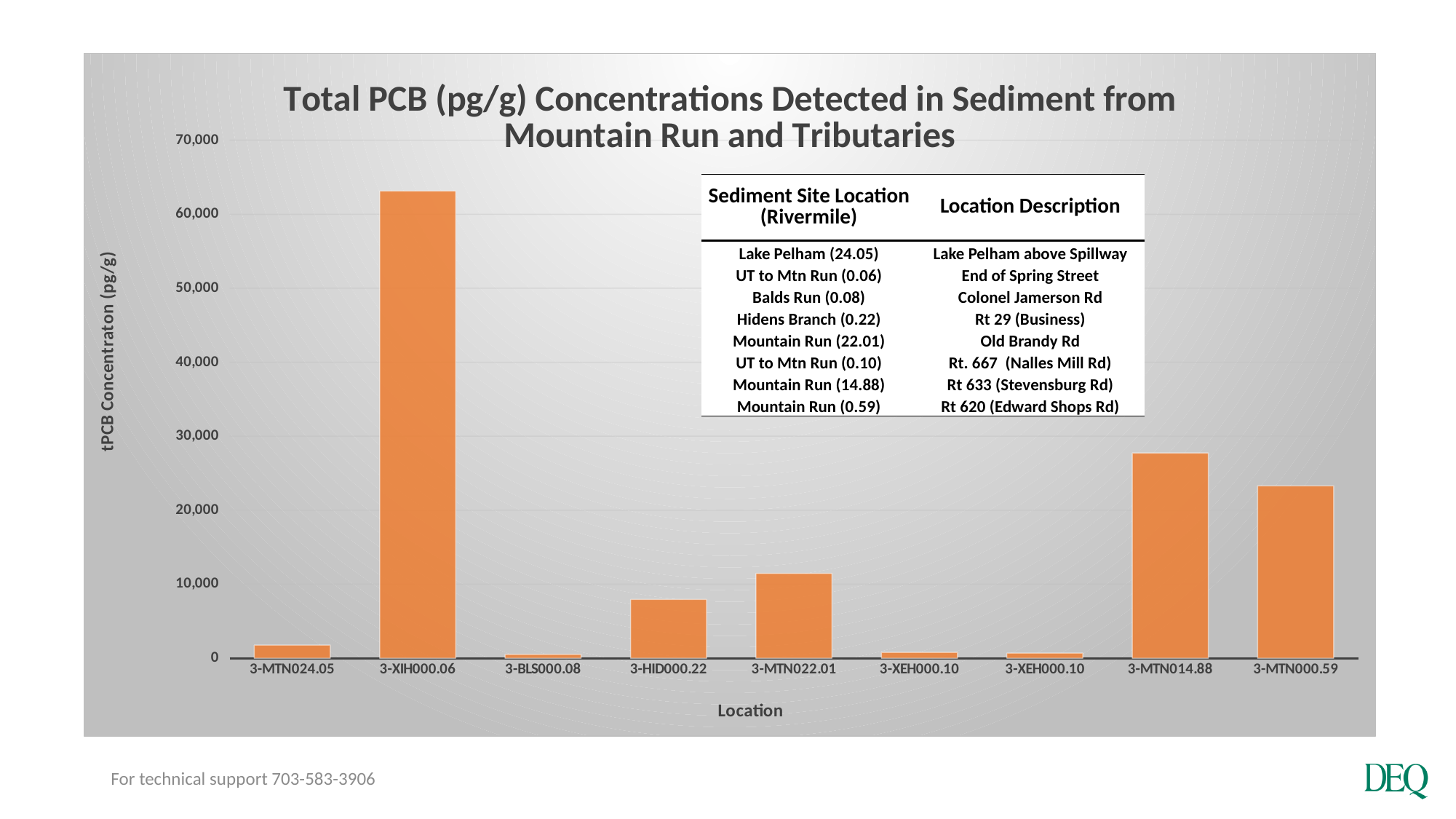
Is the value for 3-MTN014.88 greater or less than 30,000? less Is the value for 3-XIH000.06 greater or less than 60,000? greater Which has the larger tPCB concentration, 3-MTN022.01 or 3-HID000.22? 3-MTN022.01 What kind of chart is shown on the slide? bar chart How many locations (bars) are plotted on the chart? 9 What is the label of the vertical axis? tPCB Concentraton (pg/g) What is the title of the chart? Total PCB (pg/g) Concentrations Detected in Sediment from Mountain Run and Tributaries Is the value for 3-MTN022.01 greater or less than 10,000? greater Which location has the highest tPCB concentration? 3-XIH000.06 Which has the larger tPCB concentration, 3-MTN014.88 or 3-MTN000.59? 3-MTN014.88